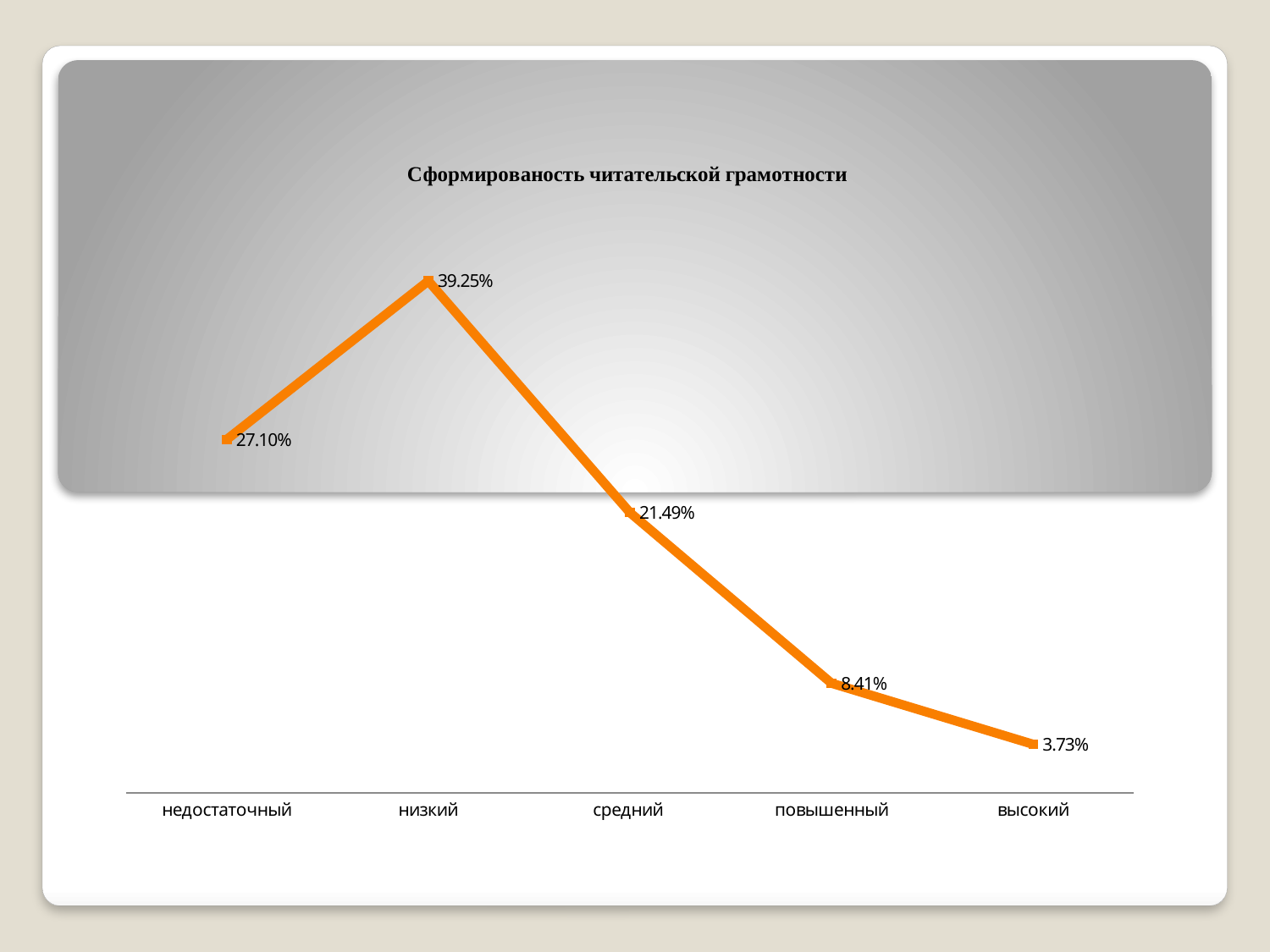
What is the value for высокий? 3.73% What is the value for недостаточный? 27.10% What is the title of the chart? Сформированость читательской грамотности How many categories are shown on the x axis? 5 Which category has the highest value? низкий What is the value for низкий? 39.25% What is the value for средний? 21.49% Which is larger, the value for средний or the value for повышенный? средний What is the difference between the values for низкий and недостаточный? 12.15% What is the value for повышенный? 8.41% Which category has the lowest value? высокий What kind of chart is this? line chart